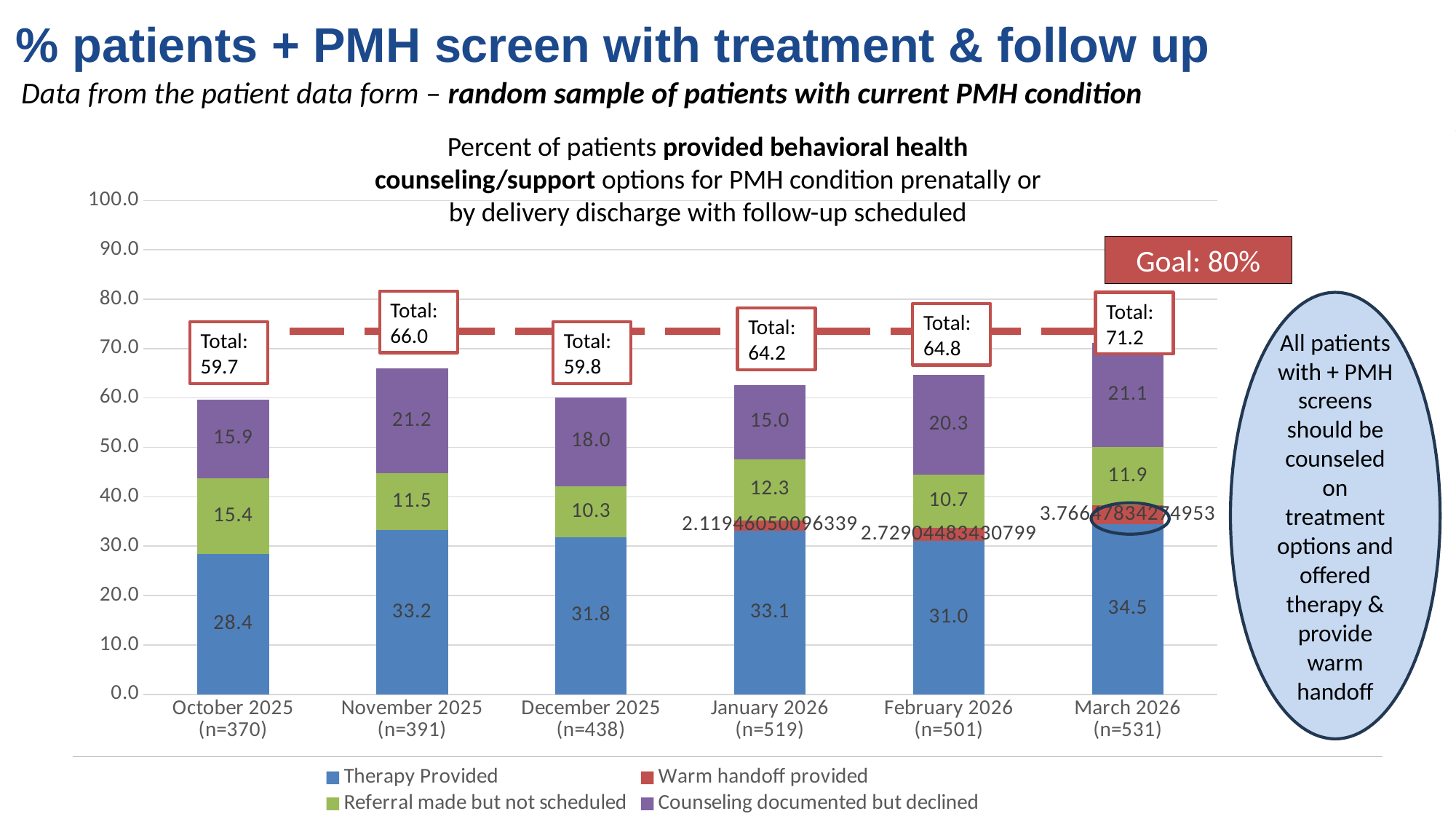
What is the difference between the Therapy Provided values for March 2026 and October 2025? 6.1 What kind of chart is shown on the slide? Stacked bar chart What is the Therapy Provided value for March 2026? 34.5 How many series does the chart legend list? 4 Which month has the lowest Therapy Provided value? October 2025 Which month has the highest total? March 2026 Which month has the larger Referral made but not scheduled value, October 2025 or November 2025? October 2025 What is the Referral made but not scheduled value for February 2026? 10.7 How many months are shown on the x axis of the chart? 6 What is the Counseling documented but declined value for November 2025? 21.2 What is the total shown for the March 2026 bar? 71.2 What goal percentage is shown on the slide? 80%